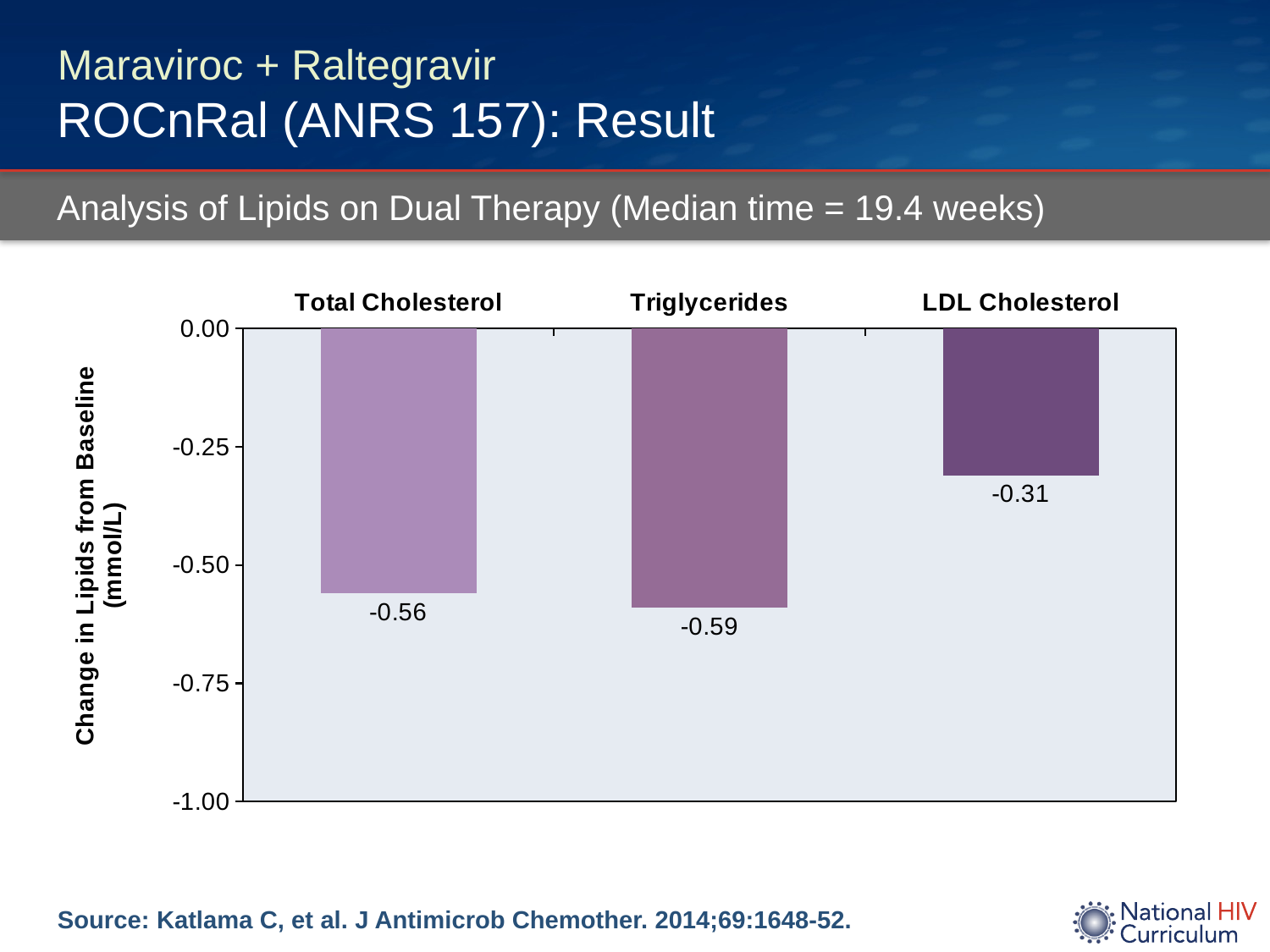
What type of chart is used to show the lipid changes? Bar chart What is the label of the vertical axis of the chart? Change in Lipids from Baseline (mmol/L) What is the change in LDL cholesterol from baseline shown on the chart? -0.31 What is the difference between the triglycerides change and the total cholesterol change (in mmol/L)? 0.03 Which lipid parameter shows the largest decrease from baseline? Triglycerides Which lipid parameter shows the smallest decrease from baseline? LDL Cholesterol Which decreased more from baseline, total cholesterol or LDL cholesterol? Total Cholesterol Is the change in LDL cholesterol greater or less than -0.25? less By how much does the decrease in total cholesterol exceed the decrease in LDL cholesterol (in mmol/L)? 0.25 What is the change in triglycerides from baseline shown on the chart? -0.59 What is the change in total cholesterol from baseline shown on the chart? -0.56 How many lipid parameters are plotted on the chart? 3